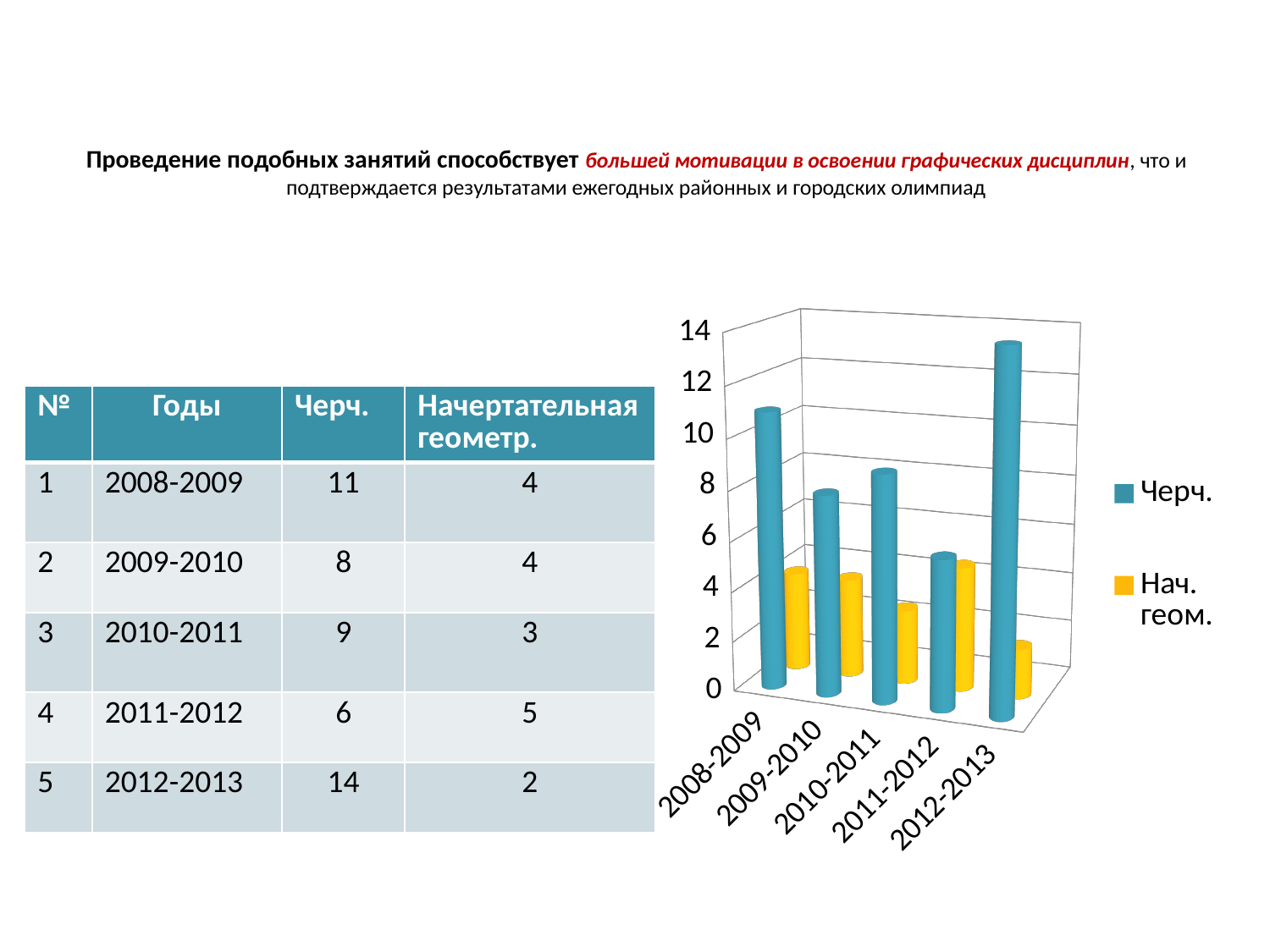
Is the value for Черч. in 2008-2009 greater or less than 10? greater What is the value for Начертательная геометр. in 2011-2012? 5 What kind of chart is shown on the slide? bar chart Which year has the lowest value for Нач. геом.? 2012-2013 Which year has the highest value for Черч.? 2012-2013 How many series does the chart legend list? 2 Is the value for Нач. геом. in 2012-2013 greater or less than 4? less Which is larger in 2009-2010, the value for Черч. or the value for Нач. геом.? Черч. How many year categories are shown on the chart's x axis? 5 What is the value for Черч. in 2012-2013? 14 What is the difference between the Черч. values for 2012-2013 and 2011-2012? 8 Which year has the lowest value for Черч.? 2011-2012